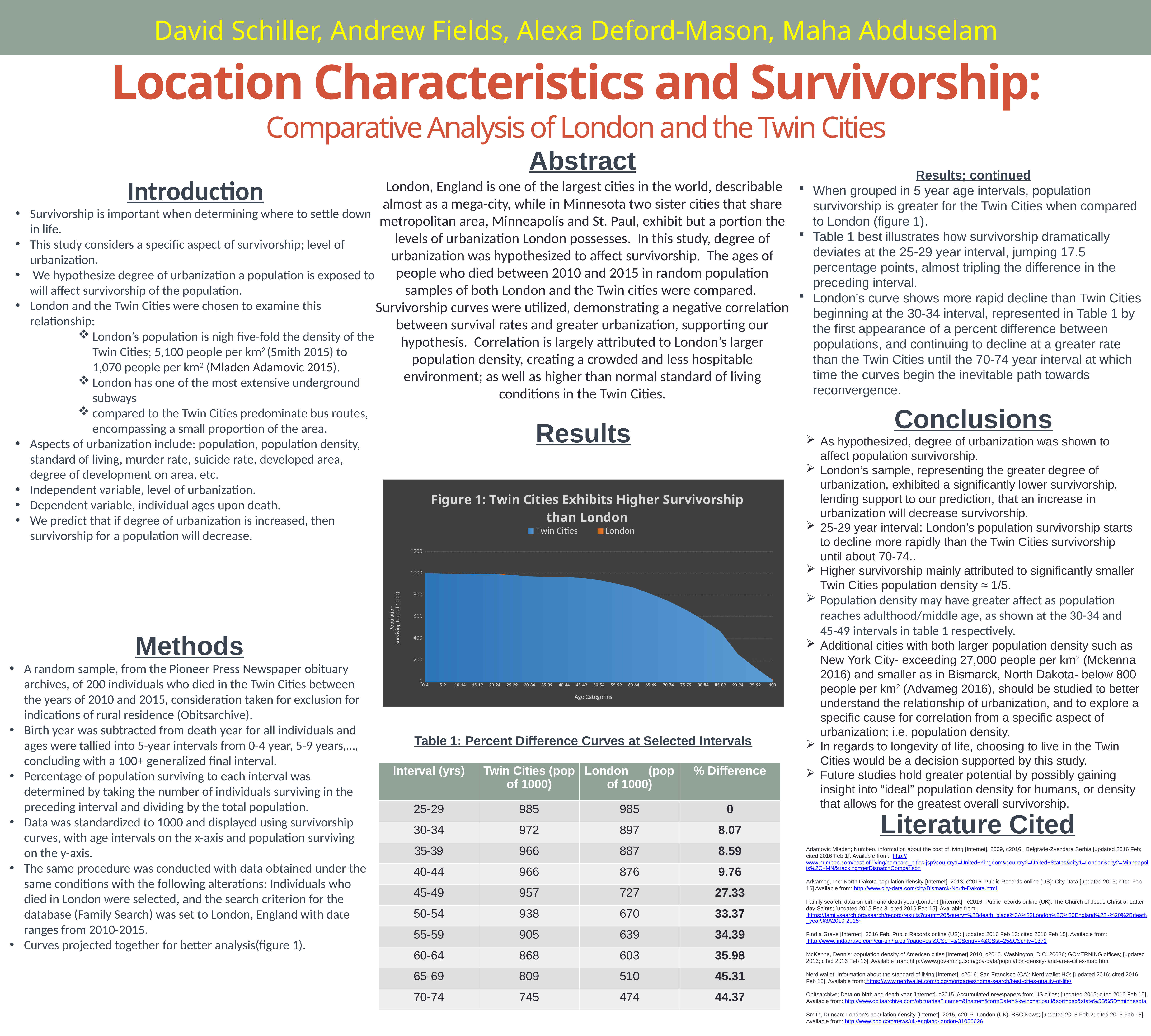
In Figure 1, is the Twin Cities value for the 70-74 age category greater or less than 600? greater In Figure 1, which age category has the highest population surviving? 0-4 In Figure 1, which age category has the lowest population surviving? 100 In Figure 1, is the Twin Cities value for the 0-4 age category greater or less than 800? greater In Figure 1, which colour represents the Twin Cities series? Blue How many series does the legend of Figure 1 list? 2 Do the values in Figure 1 rise or fall as age increases along the x axis? Fall What is the title of the chart on the slide? Figure 1: Twin Cities Exhibits Higher Survivorship than London What kind of chart is Figure 1? Area chart How many age categories are shown on the x axis of Figure 1? 21 In Figure 1, is the Twin Cities value for the 100 age category greater or less than 200? less